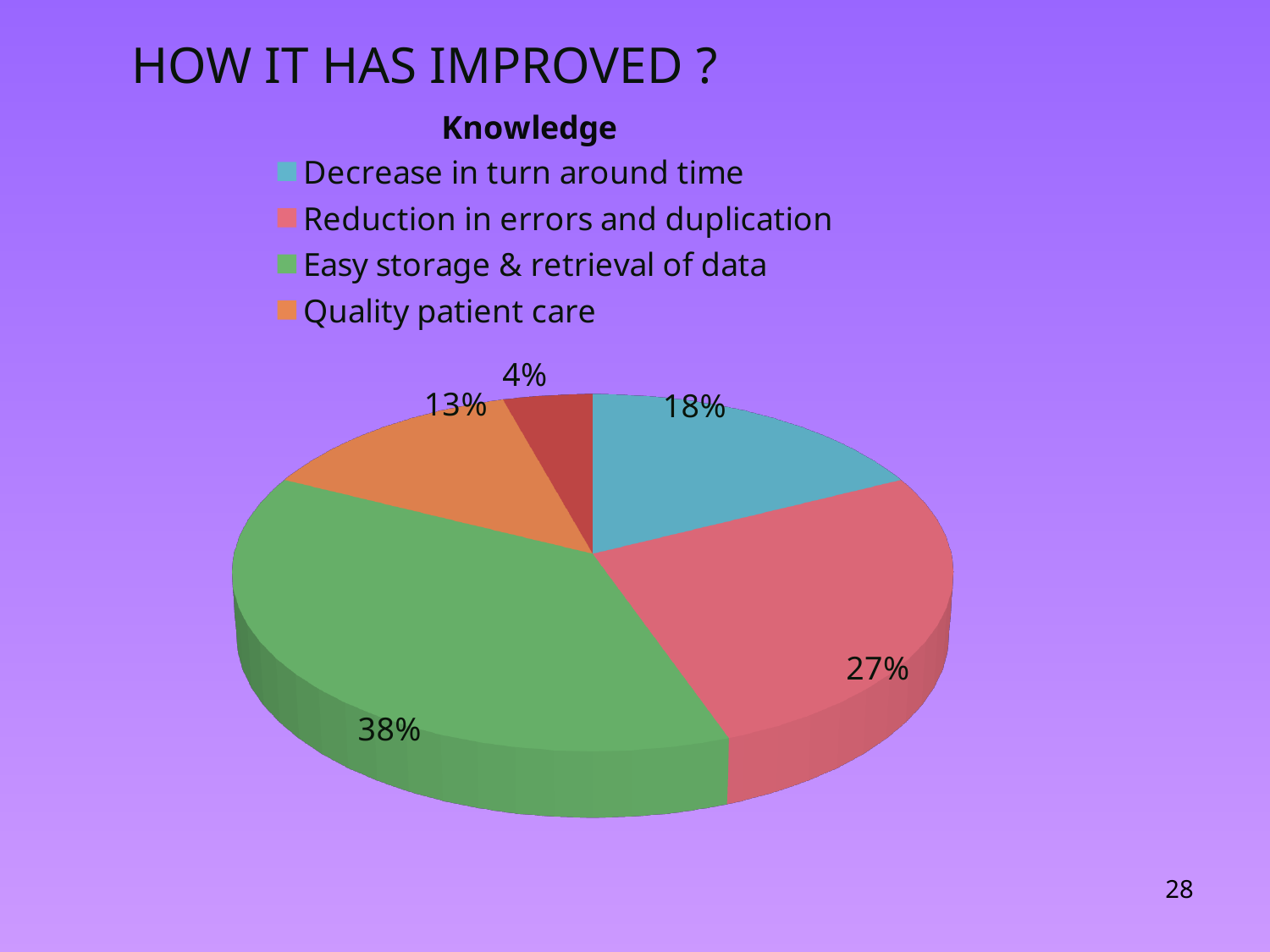
Which category has the largest slice of the pie? Easy storage & retrieval of data What share of the pie does Quality patient care have? 13% What is the difference in percentage points between Easy storage & retrieval of data and Reduction in errors and duplication? 11 What share of the pie does Decrease in turn around time have? 18% What kind of chart is shown on the slide? Pie chart How many slices does the pie chart have? 5 What share of the pie does Reduction in errors and duplication have? 27% What is the percentage shown on the smallest slice of the pie? 4% Which is larger, the slice for Decrease in turn around time or the slice for Quality patient care? Decrease in turn around time How many entries does the chart legend list? 4 What is the title of the chart? Knowledge